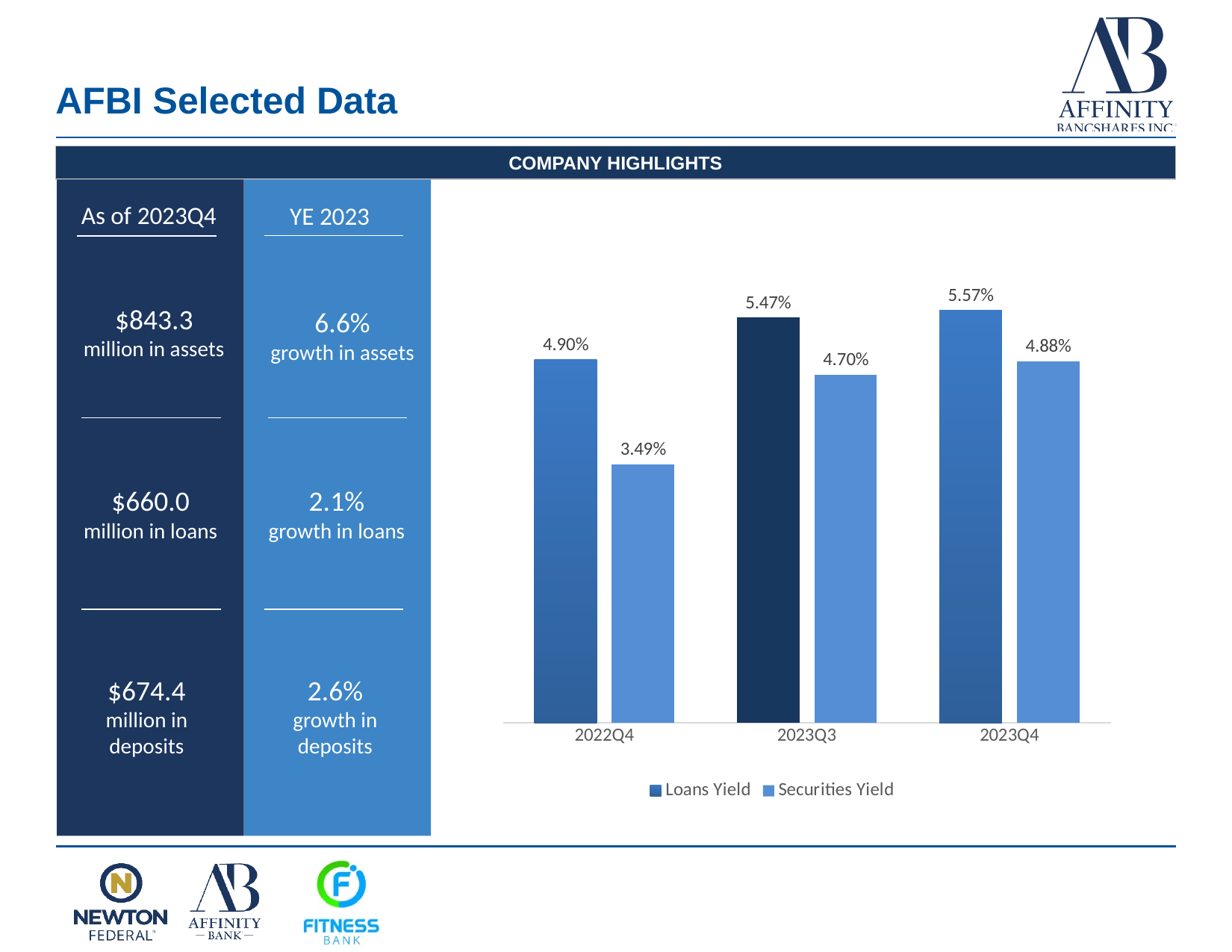
How many periods are shown on the x axis of the chart? 3 What is the Securities Yield for 2023Q4? 4.88% What is the difference between the Loans Yield and the Securities Yield in 2022Q4? 1.41% What is the Securities Yield for 2022Q4? 3.49% Which period has the lowest Securities Yield? 2022Q4 What kind of chart is shown on the slide? Bar chart Which is larger in 2023Q3: the Loans Yield or the Securities Yield? Loans Yield How many series does the chart legend list? 2 Does the Securities Yield rise or fall from 2022Q4 to 2023Q4? Rise Which period has the highest Loans Yield? 2023Q4 What is the Loans Yield for 2023Q3? 5.47% What is the Loans Yield for 2023Q4? 5.57%